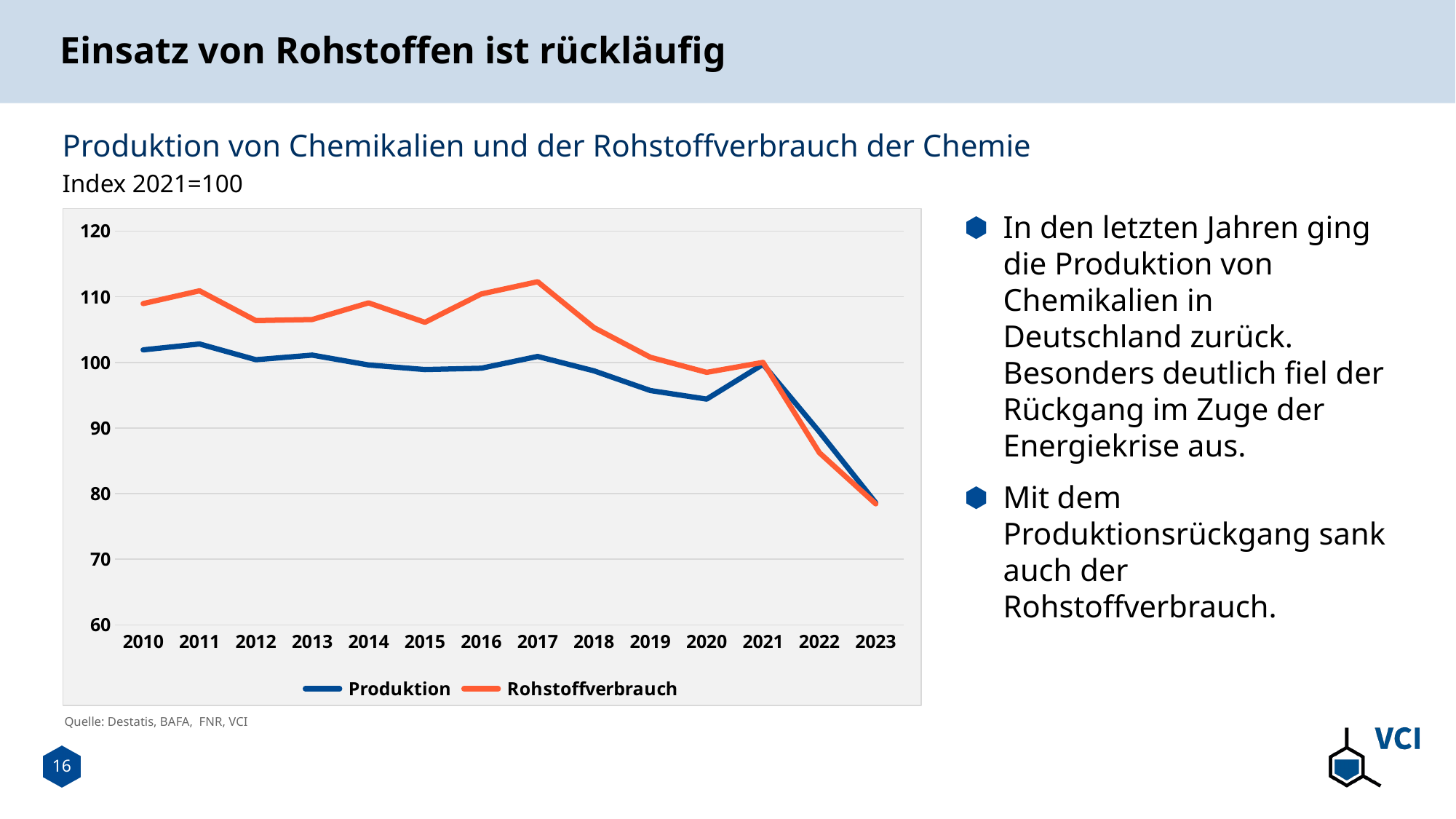
Which series has the higher value in 2015, Produktion or Rohstoffverbrauch? Rohstoffverbrauch What base year is used for the index in the chart? 2021 How many years are shown on the x axis of the chart? 14 Is the value for Produktion in 2020 greater or less than 100? less In which year does the Rohstoffverbrauch line reach its highest value? 2017 Is the value for Rohstoffverbrauch in 2022 greater or less than 90? less What kind of chart is shown on the slide? Line chart Is the value for Rohstoffverbrauch in 2017 greater or less than 110? greater In which year does the Produktion line reach its lowest value? 2023 Do the values of Produktion rise or fall from 2021 to 2023? Fall How many series does the chart legend list? 2